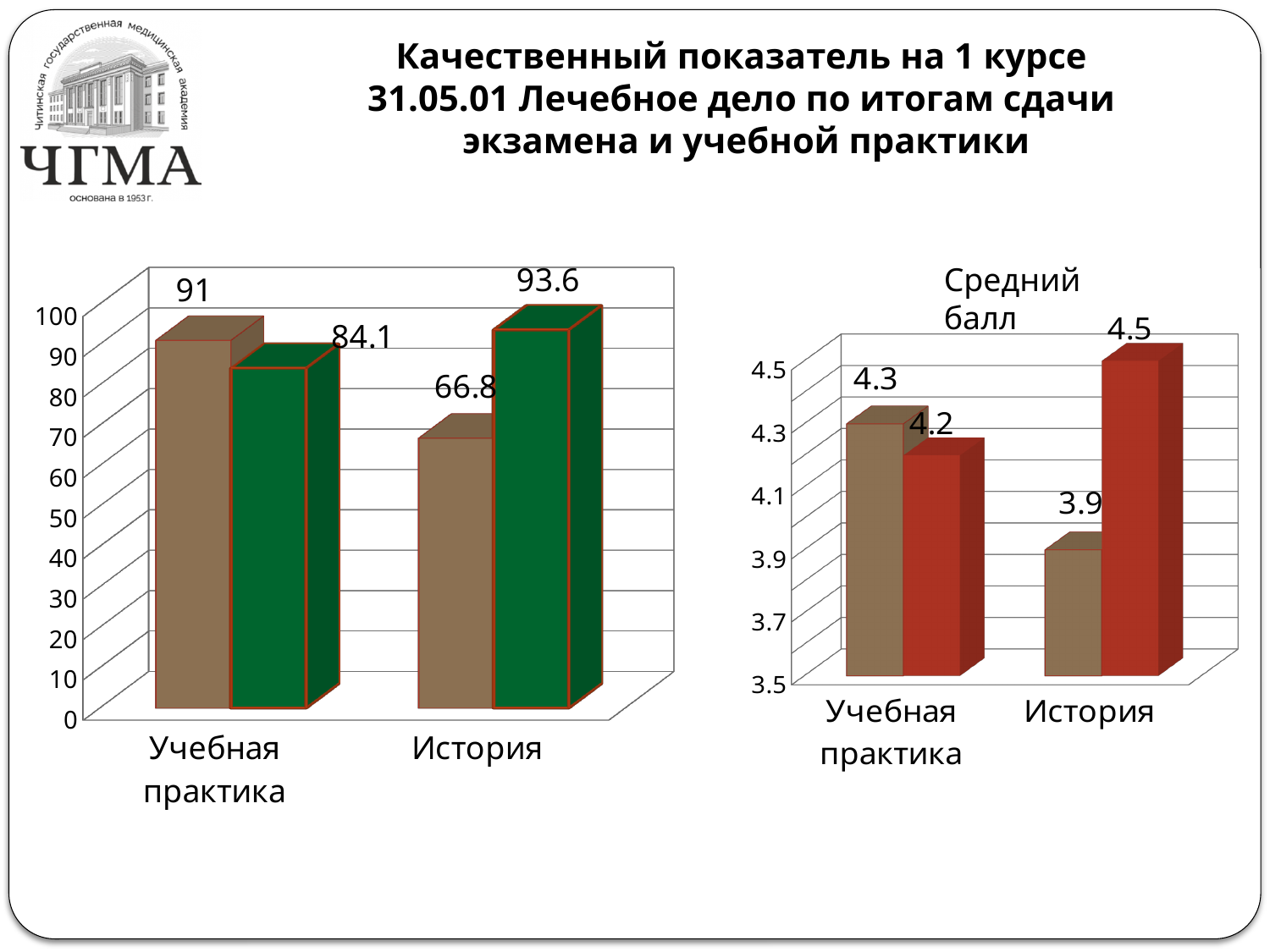
In the left chart, what is the difference between the green bar and the brown bar for История? 26.8 In the chart titled Средний балл, what is the difference between the red bar and the brown bar for История? 0.6 In the chart titled Средний балл, what is the value of the red bar for История? 4.5 In the chart titled Средний балл, what is the value of the brown bar for Учебная практика? 4.3 What type of chart is the left chart? Bar chart In the left chart, what is the value of the brown bar for История? 66.8 In the left chart, what is the value of the green bar for История? 93.6 How many categories are shown on the x axis of the chart titled Средний балл? 2 In the left chart, which bar is the lowest? Brown bar for История (66.8) In the left chart, what is the value of the brown bar for Учебная практика? 91 In the left chart, which is larger for Учебная практика: the brown bar or the green bar? Brown bar (91) In the chart titled Средний балл, which bar is the lowest? Brown bar for История (3.9)